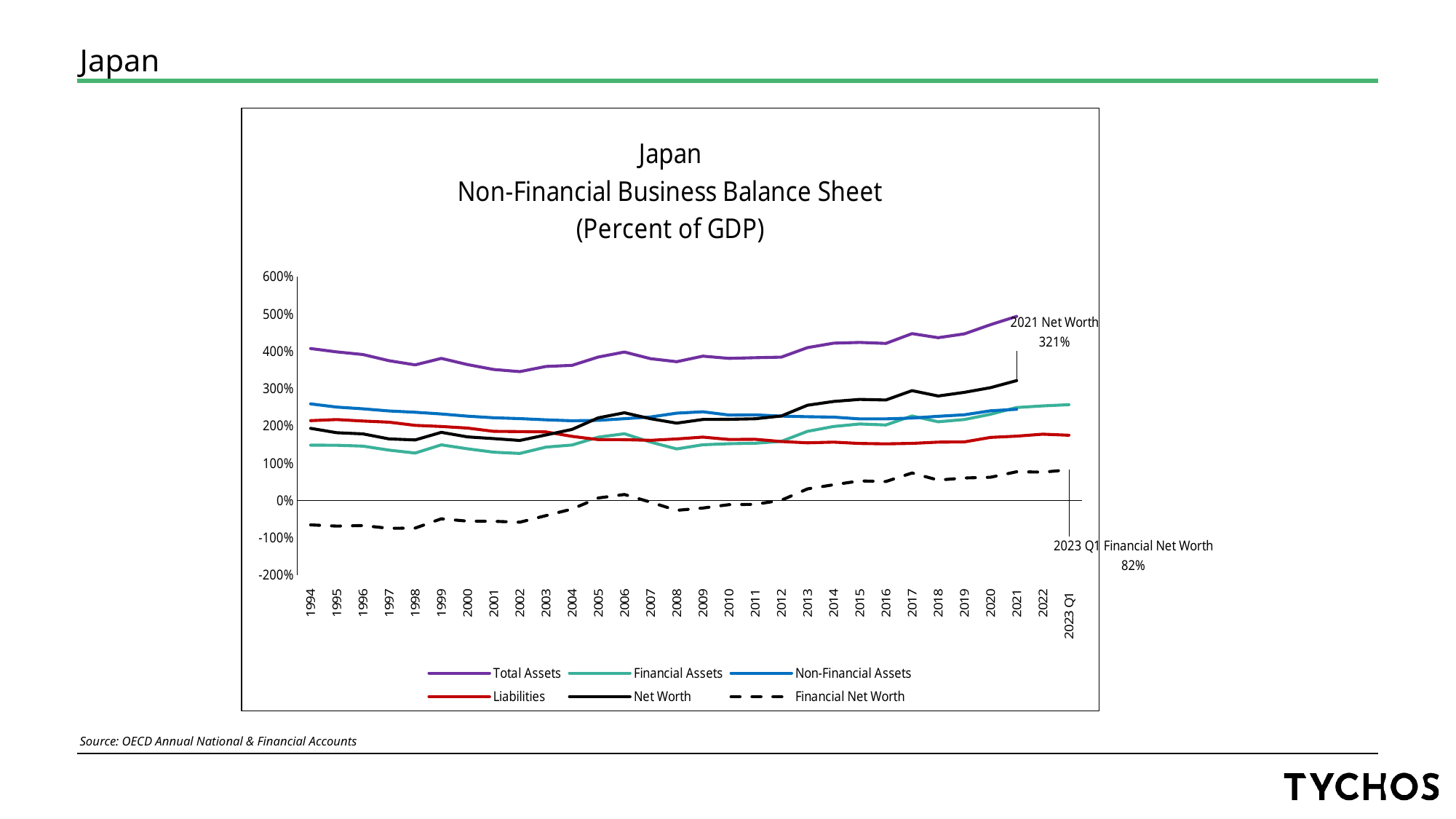
What is the Financial Net Worth value labelled for 2023 Q1? 82% Which is larger in 2021, Total Assets or Liabilities? Total Assets How many series does the legend list? 6 What is the title of the chart? Japan Non-Financial Business Balance Sheet (Percent of GDP) What kind of chart is shown on the slide? Line chart Is the value for Financial Net Worth in 1994 greater or less than 0%? less Is the value for Total Assets in 1994 greater or less than 300%? greater Which series has the lowest value in 1994? Financial Net Worth Which series has the highest value in 2021? Total Assets Which series is drawn with a dashed line? Financial Net Worth Does Net Worth rise or fall between 2012 and 2021? Rise What is the Net Worth value labelled for 2021? 321%